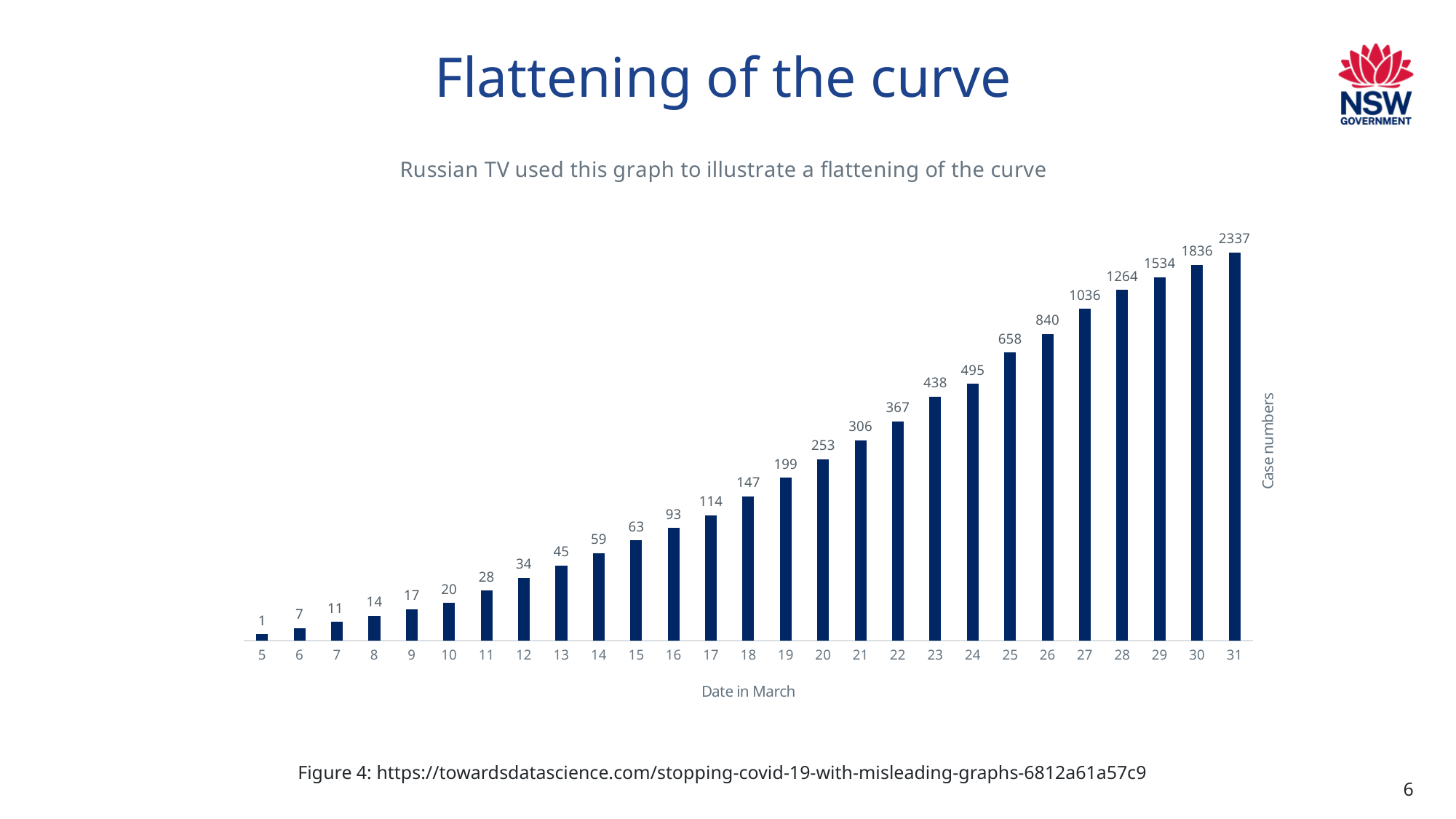
What is the difference between the case numbers for 25 March and 24 March? 163 What is the case number for 31 March? 2337 Do the case numbers rise or fall from 5 March to 31 March? Rise What is the case number for 20 March? 253 How many dates are shown on the x axis? 27 What is the label of the x axis? Date in March What kind of chart is shown on the slide? Bar chart Which has a larger case number, 18 March or 22 March? 22 March Which date in March has the highest case number? 31 What is the case number for 12 March? 34 Which date in March has the lowest case number? 5 What is the difference between the case numbers for 31 March and 30 March? 501